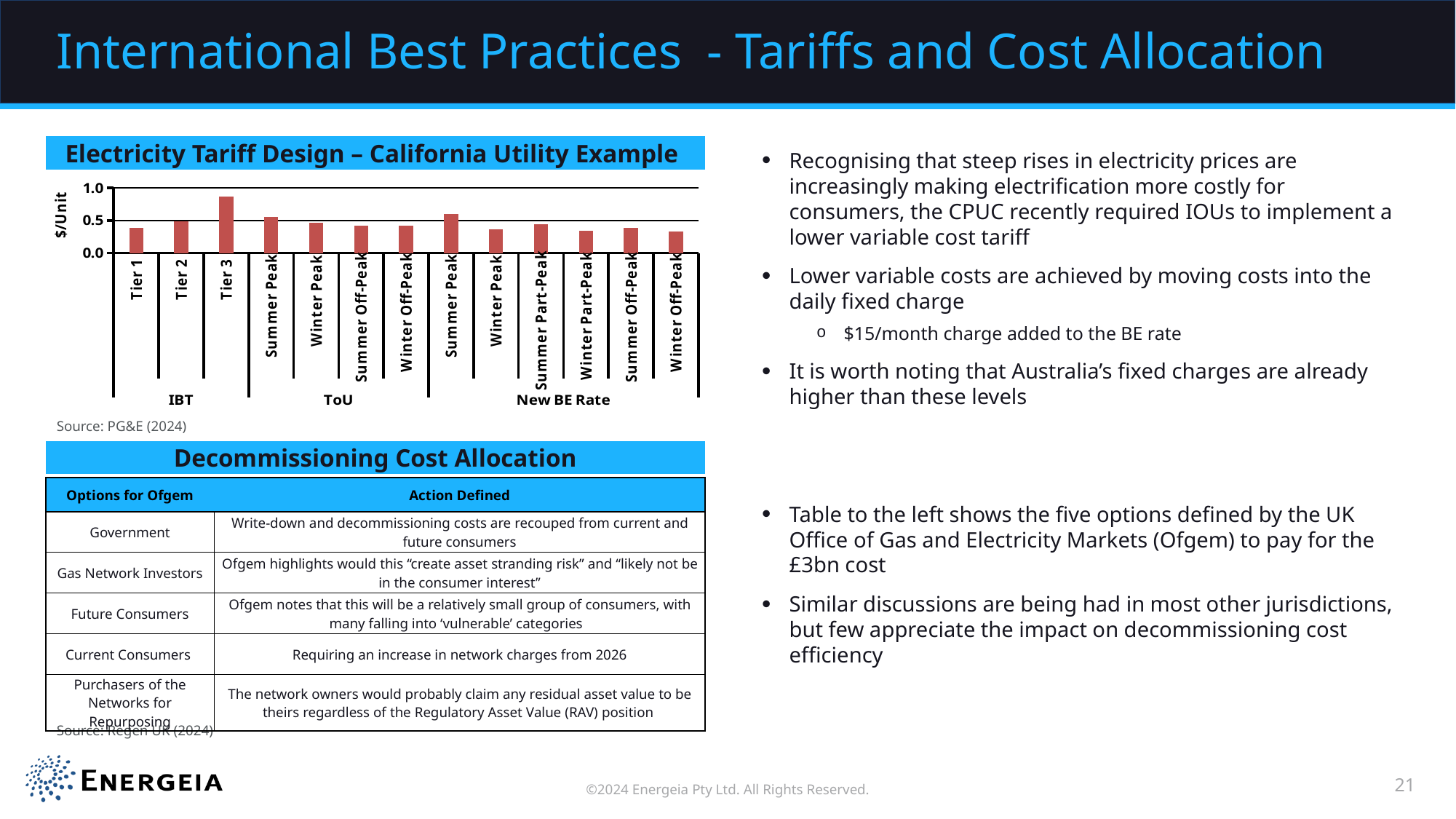
In the 'Electricity Tariff Design – California Utility Example' chart, which is larger under New BE Rate: Summer Peak or Winter Peak? Summer Peak In the 'Electricity Tariff Design – California Utility Example' chart, is the value for Winter Off-Peak under New BE Rate greater or less than 0.5? less In the 'Electricity Tariff Design – California Utility Example' chart, is the value for Tier 1 greater or less than 0.5? less In the 'Electricity Tariff Design – California Utility Example' chart, is the value for Summer Peak under ToU greater or less than 0.5? greater In the 'Electricity Tariff Design – California Utility Example' chart, which category has the highest value? Tier 3 What type of chart is used in the 'Electricity Tariff Design – California Utility Example'? Bar chart What is the y-axis label of the 'Electricity Tariff Design – California Utility Example' chart? $/Unit What are the three tariff groups shown along the x-axis of the 'Electricity Tariff Design – California Utility Example' chart? IBT, ToU, New BE Rate In the 'Electricity Tariff Design – California Utility Example' chart, which is larger: Tier 3 or Tier 1? Tier 3 How many bars are plotted in the 'Electricity Tariff Design – California Utility Example' chart? 13 In the 'Electricity Tariff Design – California Utility Example' chart, which is larger under ToU: Summer Peak or Winter Off-Peak? Summer Peak